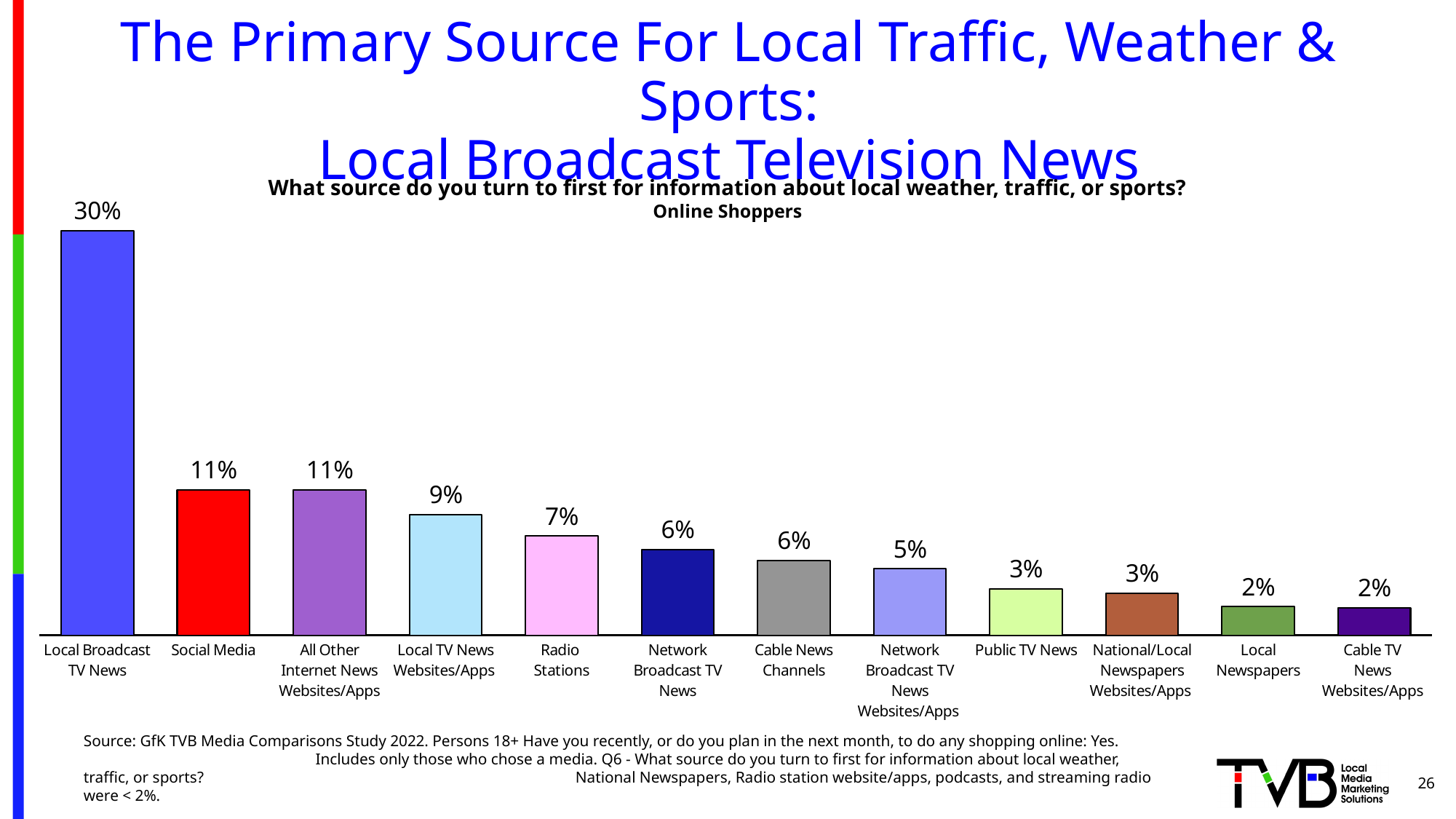
Do the values rise or fall moving from left to right across the chart? Fall Which source has the highest value in the chart? Local Broadcast TV News What is the value shown for Network Broadcast TV News Websites/Apps? 5% What is the value shown for Radio Stations? 7% How many sources (bars) are shown in the chart? 12 What is the difference between the values for Local Broadcast TV News and Social Media? 19% What is the value shown for Public TV News? 3% Which is larger, the value for Local TV News Websites/Apps or the value for Cable News Channels? Local TV News Websites/Apps What group of respondents does the chart cover, according to the chart subtitle? Online Shoppers What kind of chart is shown on the slide? Bar chart What is the difference between the values for Radio Stations and Local Newspapers? 5% What percentage of online shoppers turn first to Local Broadcast TV News for local weather, traffic, or sports? 30%